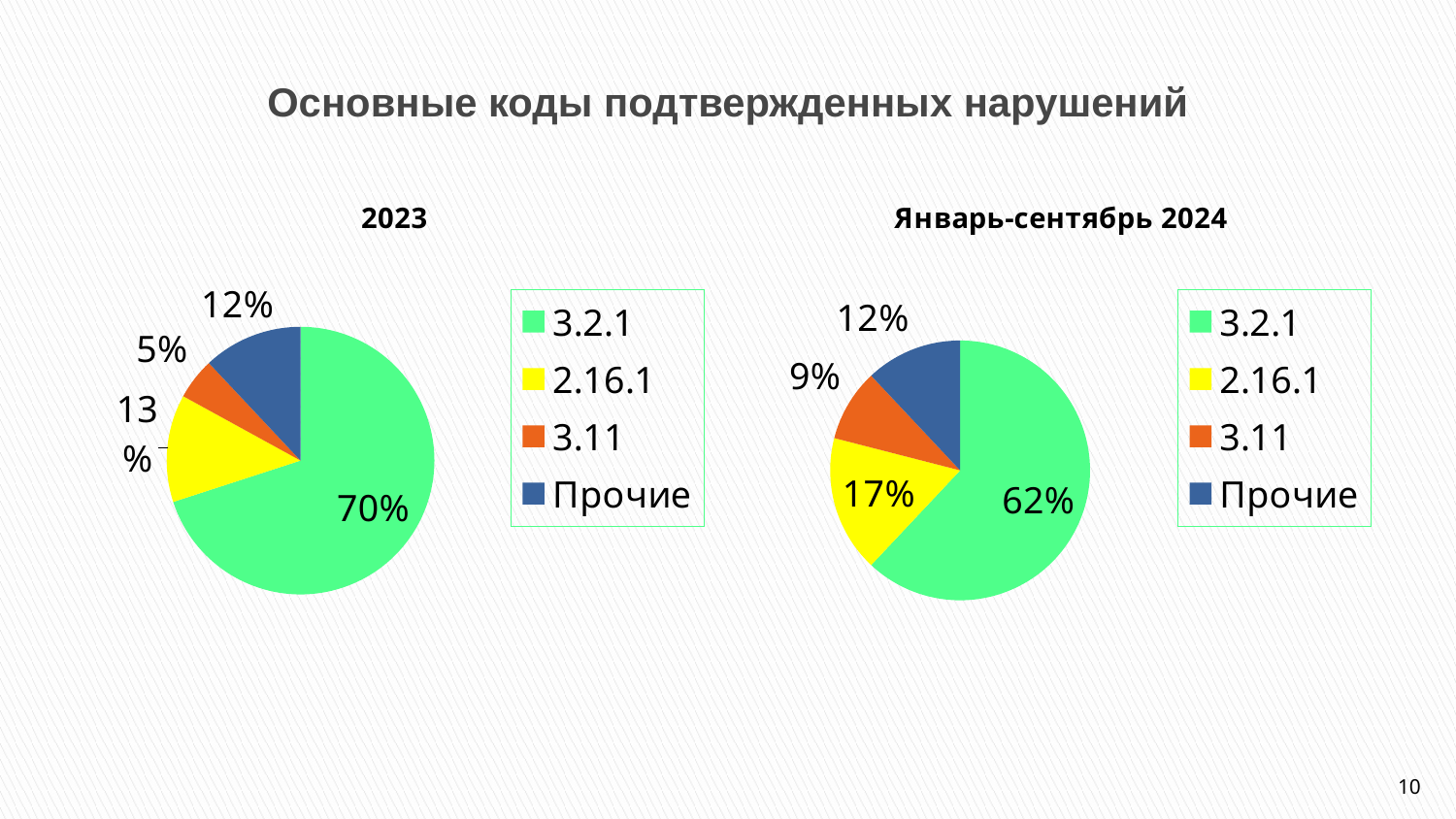
In the 2023 chart, what share does 3.2.1 have? 70% In the Январь-сентябрь 2024 chart, which category has the largest slice? 3.2.1 In the 2023 chart, what share does 3.11 have? 5% In the Январь-сентябрь 2024 chart, what share does 2.16.1 have? 17% In the Январь-сентябрь 2024 chart, what share does 3.2.1 have? 62% In the Январь-сентябрь 2024 chart, what share does Прочие have? 12% In the Январь-сентябрь 2024 chart, what is the difference between the shares of 2.16.1 and 3.11? 8% In the 2023 chart, what share does 2.16.1 have? 13% In the 2023 chart, which category has the smallest slice? 3.11 In the 2023 chart, which is larger: the share of 2.16.1 or the share of Прочие? 2.16.1 What type of chart is the Январь-сентябрь 2024 chart? Pie chart How many entries does the legend of the 2023 chart list? 4